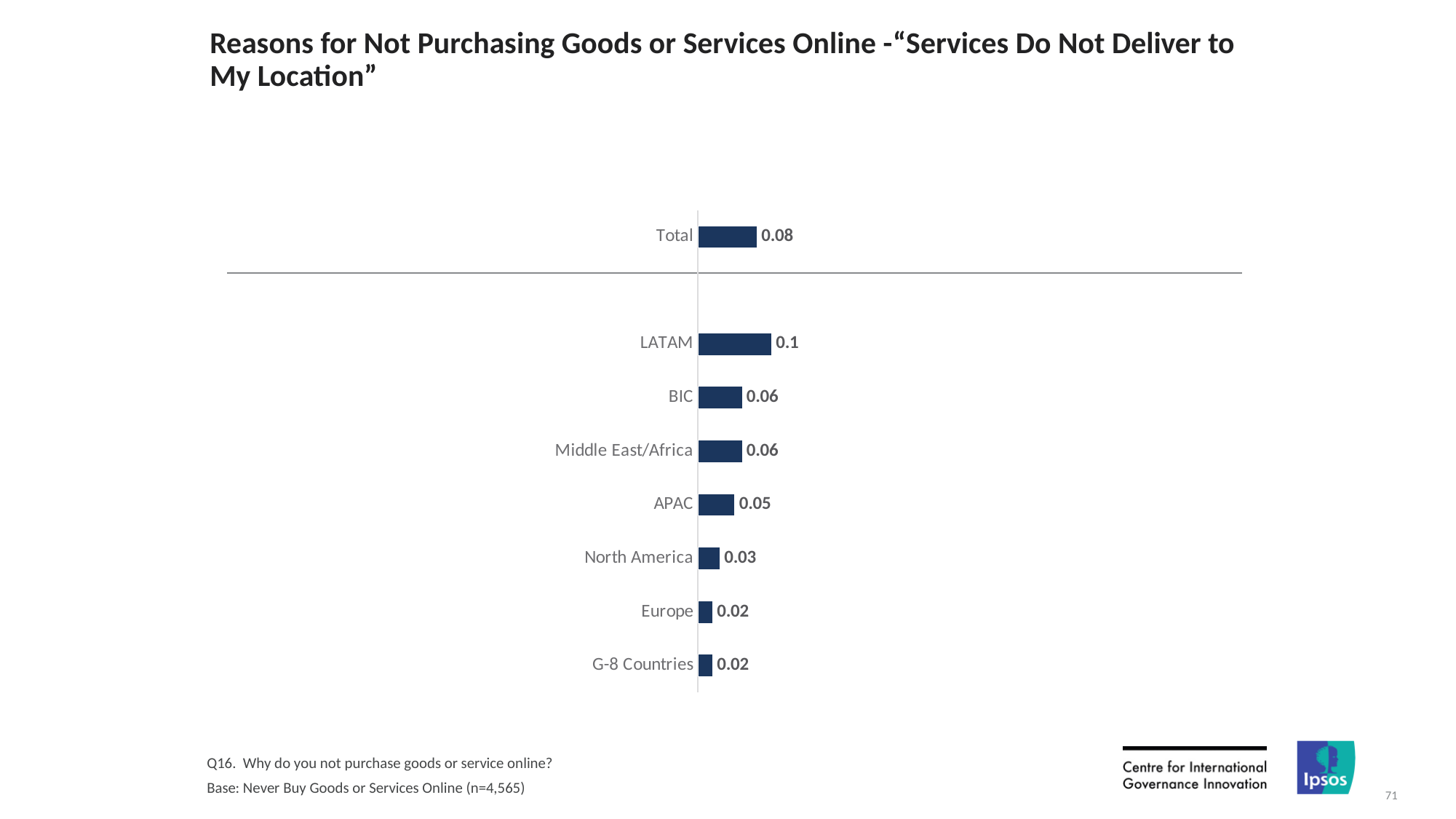
What kind of chart is shown on the slide? Bar chart What is the value for LATAM? 0.1 What is the difference between the values for Total and APAC? 0.03 What is the base size (n) stated at the bottom of the slide? n=4,565 What is the value for North America? 0.03 Which region has the highest value? LATAM What is the value for Middle East/Africa? 0.06 Which is larger, the value for APAC or the value for North America? APAC Which two regions share the lowest value of 0.02? Europe and G-8 Countries What is the difference between the values for LATAM and Europe? 0.08 How many categories are plotted on the chart, including Total? 8 What is the value for Total? 0.08